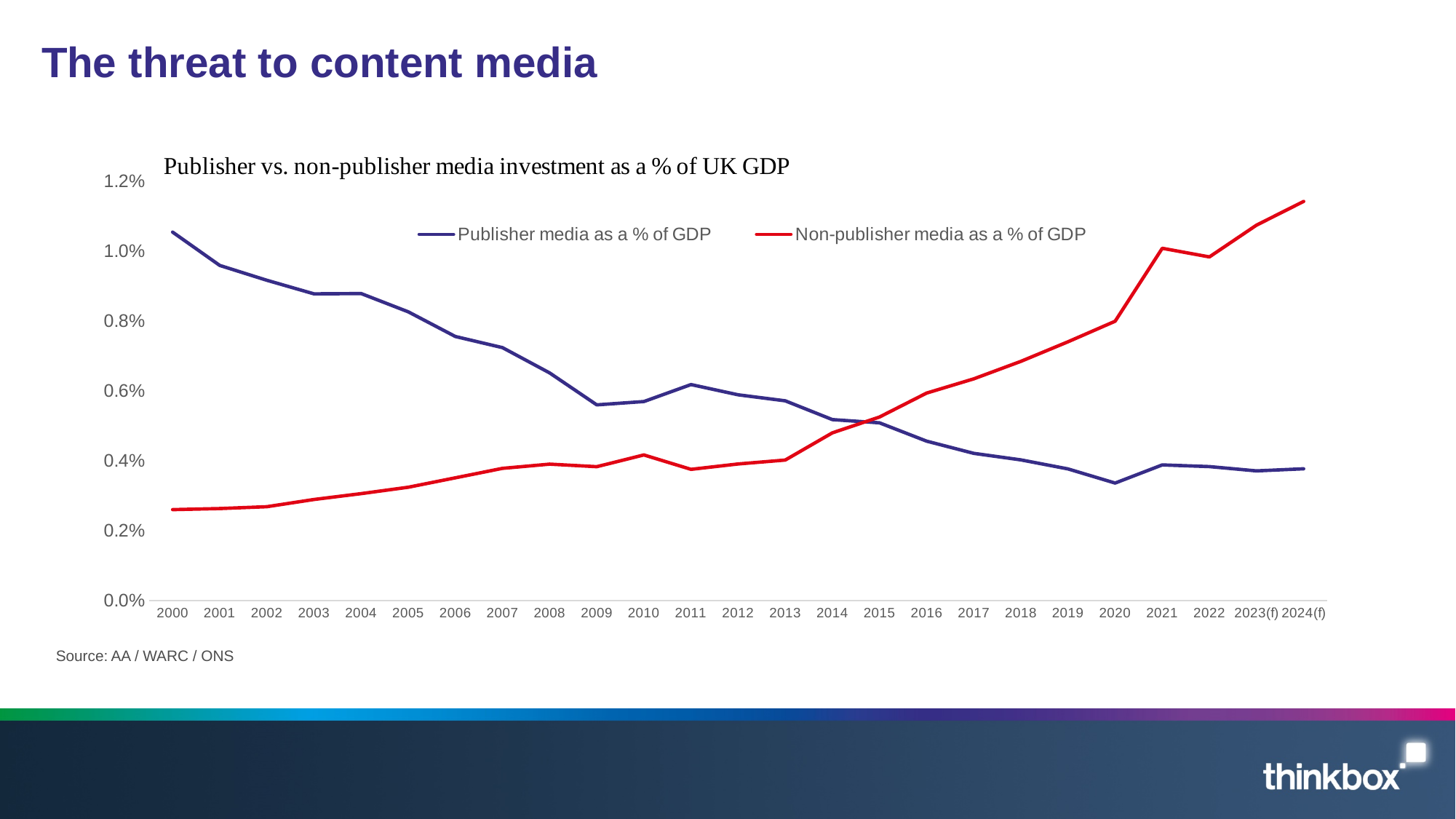
In 2010, which series has the higher value: Publisher media or Non-publisher media? Publisher media as a % of GDP Is the value for Non-publisher media as a % of GDP in 2024(f) greater or less than 1.0%? greater How many years are plotted along the x axis? 25 What kind of chart is shown on the slide? Line chart In which year does Non-publisher media as a % of GDP reach its highest value? 2024(f) How many series does the legend list? 2 What is the title of the chart? Publisher vs. non-publisher media investment as a % of UK GDP In 2020, which series has the higher value: Publisher media or Non-publisher media? Non-publisher media as a % of GDP Does the Publisher media as a % of GDP line generally rise or fall from 2000 to 2024(f)? Fall Does the Non-publisher media as a % of GDP line generally rise or fall from 2000 to 2024(f)? Rise Is the value for Publisher media as a % of GDP in 2000 greater or less than 1.0%? greater Is the value for Non-publisher media as a % of GDP in 2000 greater or less than 0.4%? less